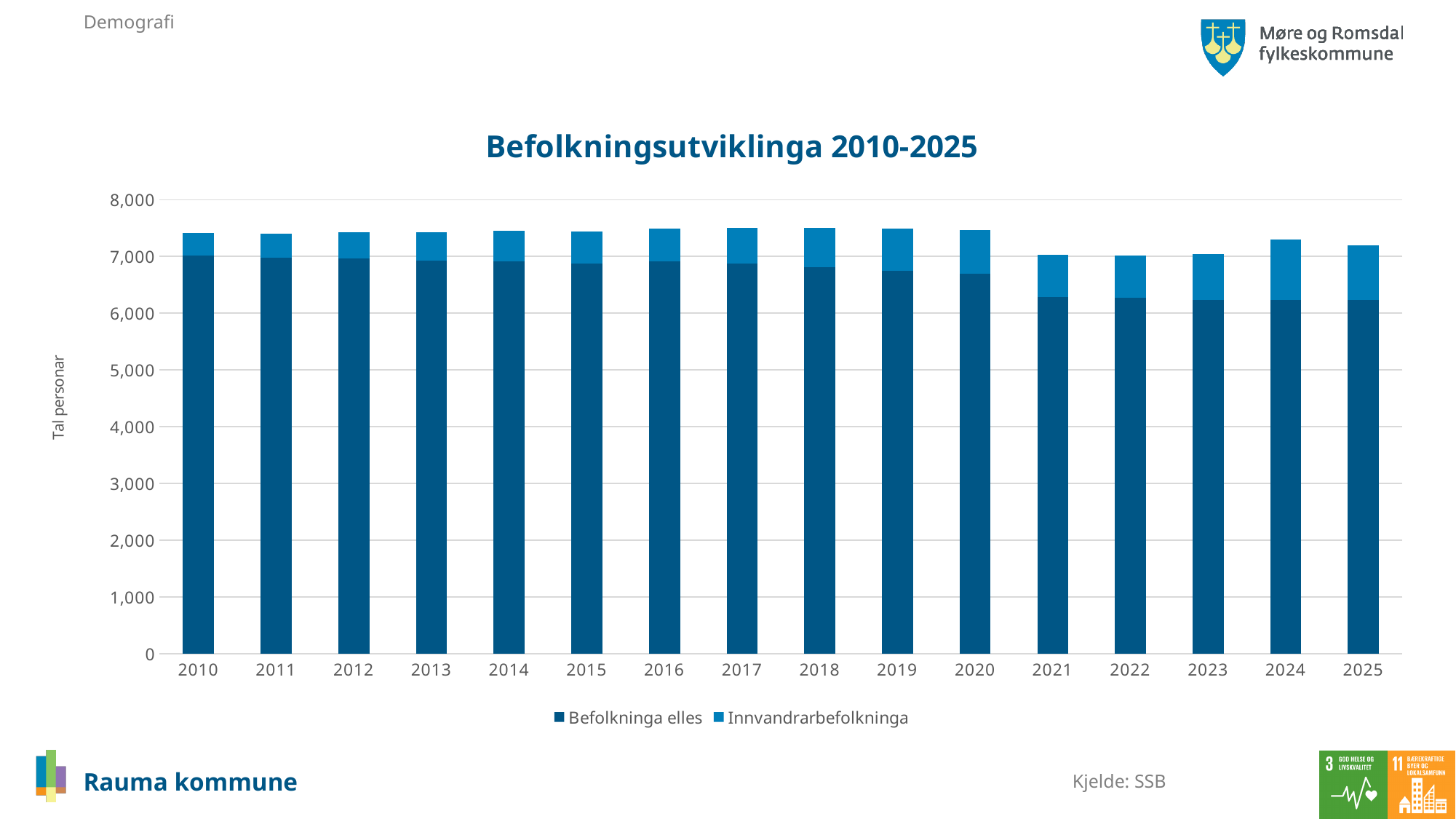
How many series does the legend list? 2 How many years are shown on the x axis of the chart? 16 Which is larger, the total stacked bar for 2010 or for 2025? 2010 Which is larger, the Innvandrarbefolkninga segment in 2010 or in 2025? 2025 Is the total height of the stacked bar for 2018 greater or less than 8,000? less Is the total height of the stacked bar for 2025 greater or less than 7,000? greater What are the two series named in the legend? Befolkninga elles and Innvandrarbefolkninga What kind of chart is shown on the slide? stacked bar chart What is the title of the chart? Befolkningsutviklinga 2010-2025 Does the Befolkninga elles series generally rise or fall from 2010 to 2025? fall Is the value for Befolkninga elles in 2021 greater or less than 6,000? greater